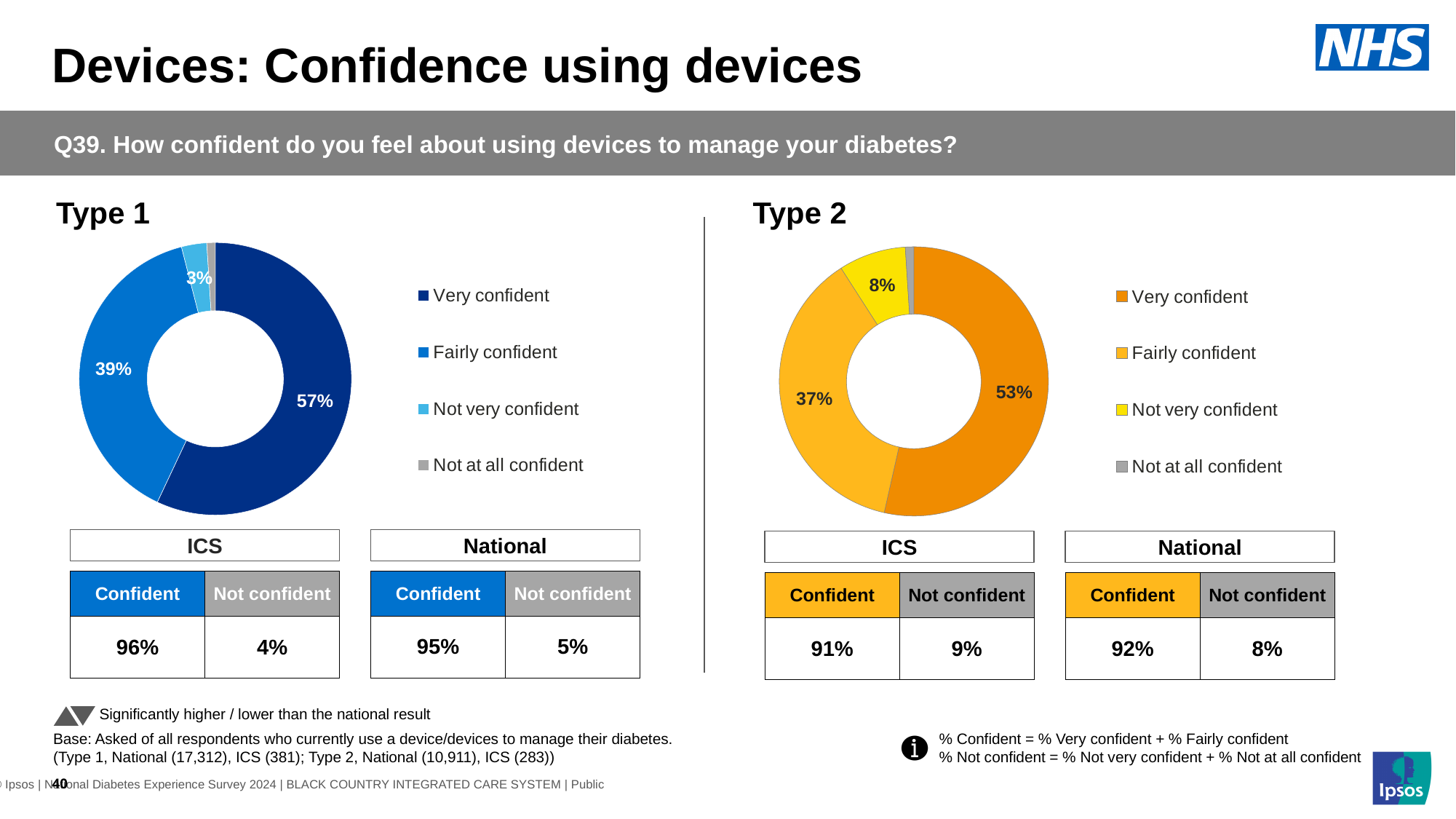
What kind of chart is used for Type 1 and Type 2? Donut (pie) chart How many categories does the legend of the Type 1 chart list? 4 In the Type 2 chart, what percentage of respondents are very confident? 53% In the Type 1 chart, what percentage of respondents are fairly confident? 39% In the Type 2 chart, what is the combined share of very confident and fairly confident respondents? 90% What colour represents 'Not at all confident' in both charts? Grey In the Type 1 chart, what percentage of respondents are not very confident? 3% In the Type 2 chart, which category has the largest share? Very confident In the Type 1 chart, what percentage of respondents are very confident? 57% In the Type 2 chart, which is larger: the fairly confident share or the not very confident share? Fairly confident In the Type 1 chart, what is the difference between the very confident and fairly confident shares? 18 percentage points In the Type 2 chart, what percentage of respondents are not very confident? 8%